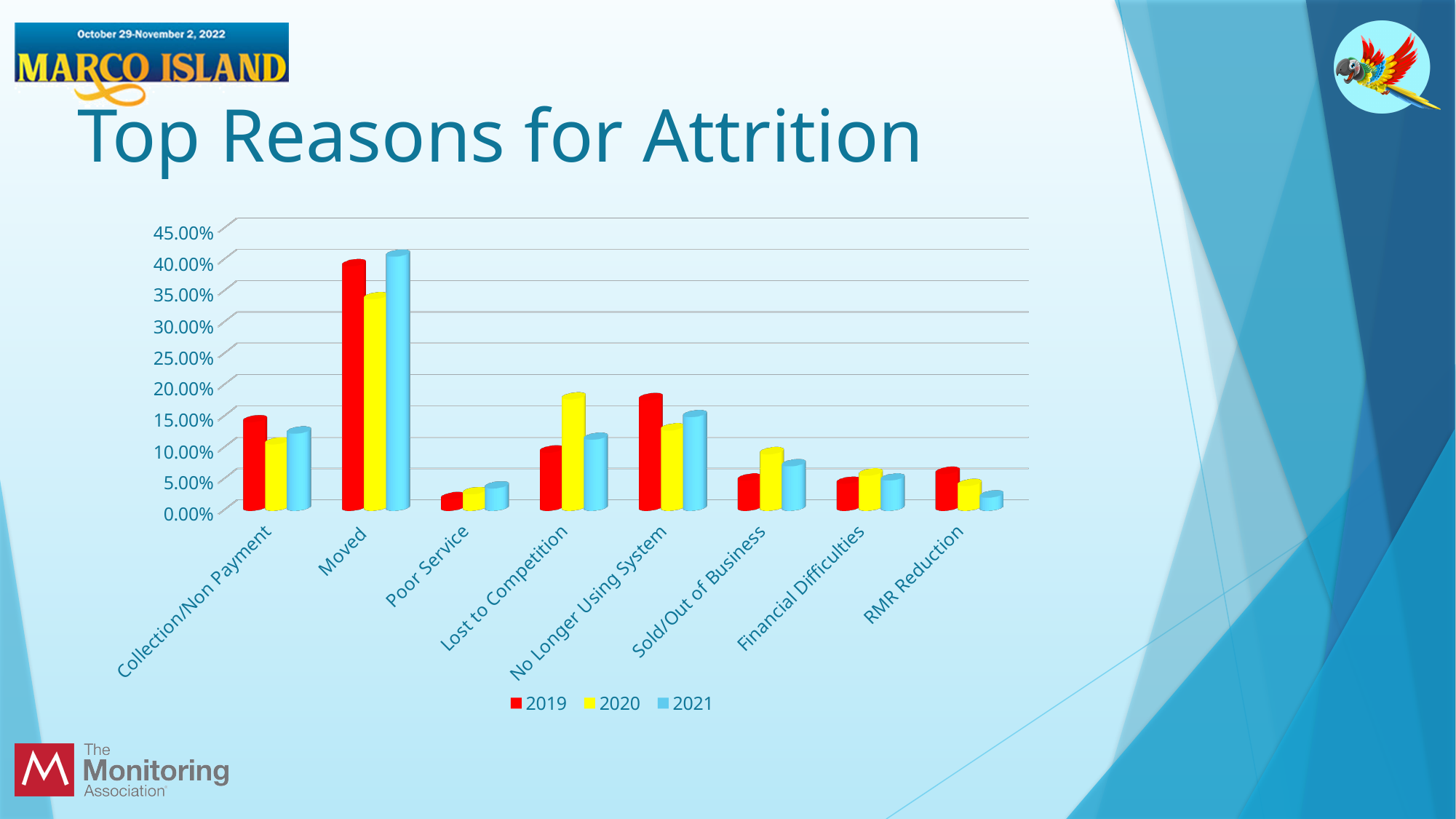
What is the title of the chart on the slide? Top Reasons for Attrition What kind of chart is shown on the slide? Bar chart Which category has the highest value for 2021? Moved Which category has the lowest value for 2019? Poor Service Is the 2019 value for Poor Service greater or less than 5.00%? less Which category has the highest value for 2019? Moved For Lost to Competition, which year has the larger value, 2019 or 2020? 2020 How many series does the legend list? 3 For No Longer Using System, which year has the larger value, 2019 or 2020? 2019 How many attrition reasons (categories) are shown on the x axis? 8 Is the 2019 value for Moved greater or less than 35.00%? greater Is the 2020 value for Lost to Competition greater or less than 15.00%? greater